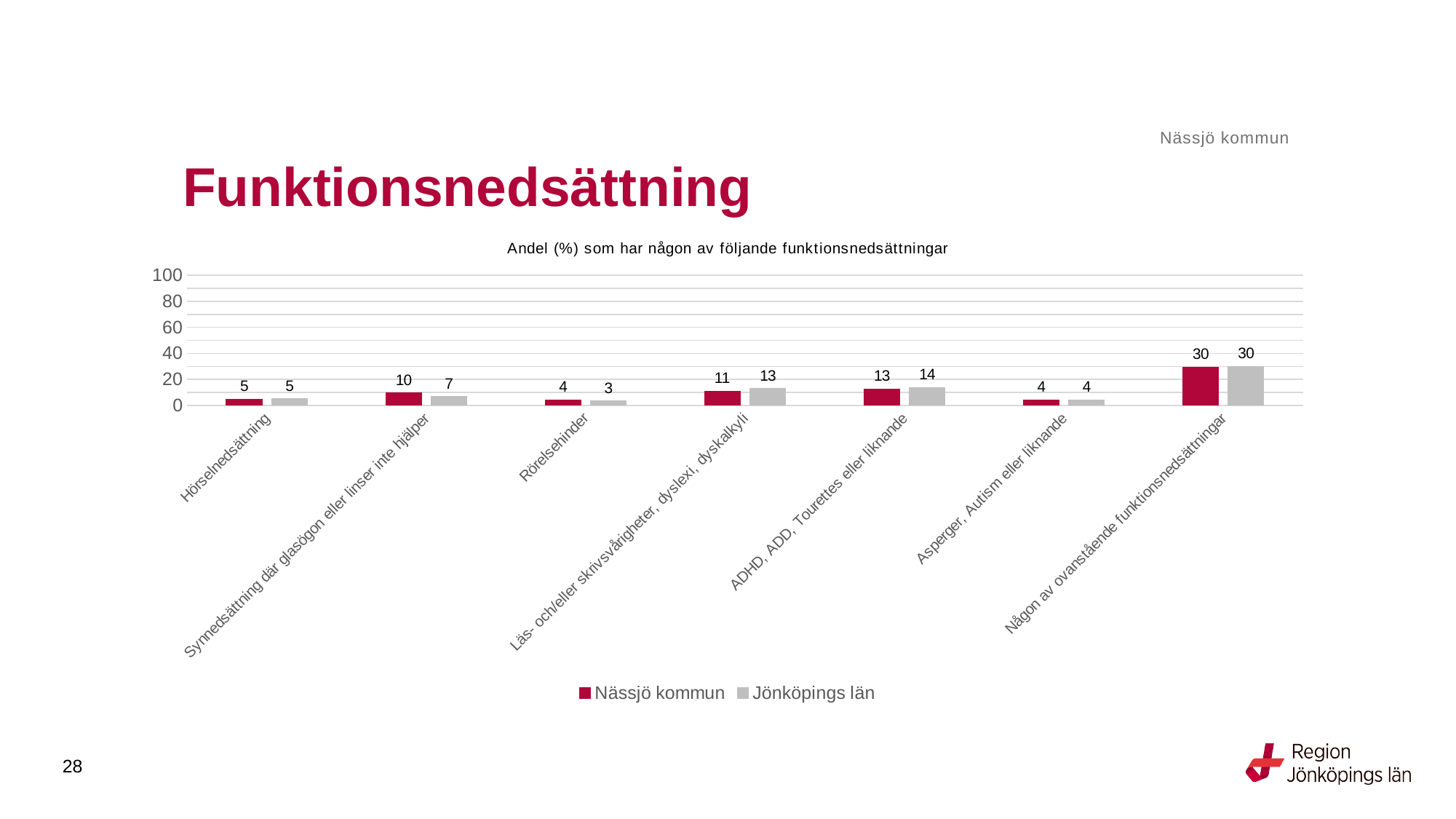
What is the value for Nässjö kommun for Hörselnedsättning? 5 What is the difference between Nässjö kommun and Jönköpings län for Synnedsättning där glasögon eller linser inte hjälper? 3 How many series does the legend list? 2 Which is larger for Läs- och/eller skrivsvårigheter, dyslexi, dyskalkyli: Nässjö kommun or Jönköpings län? Jönköpings län What kind of chart is shown on the slide? bar chart What is the value for Jönköpings län for Synnedsättning där glasögon eller linser inte hjälper? 7 Is the value for Nässjö kommun for Någon av ovanstående funktionsnedsättningar greater or less than 20? greater Which category has the highest value for Nässjö kommun? Någon av ovanstående funktionsnedsättningar Which category has the lowest value for Jönköpings län? Rörelsehinder What is the value for Nässjö kommun for ADHD, ADD, Tourettes eller liknande? 13 What is the title of the chart? Andel (%) som har någon av följande funktionsnedsättningar How many categories are shown on the x axis? 7